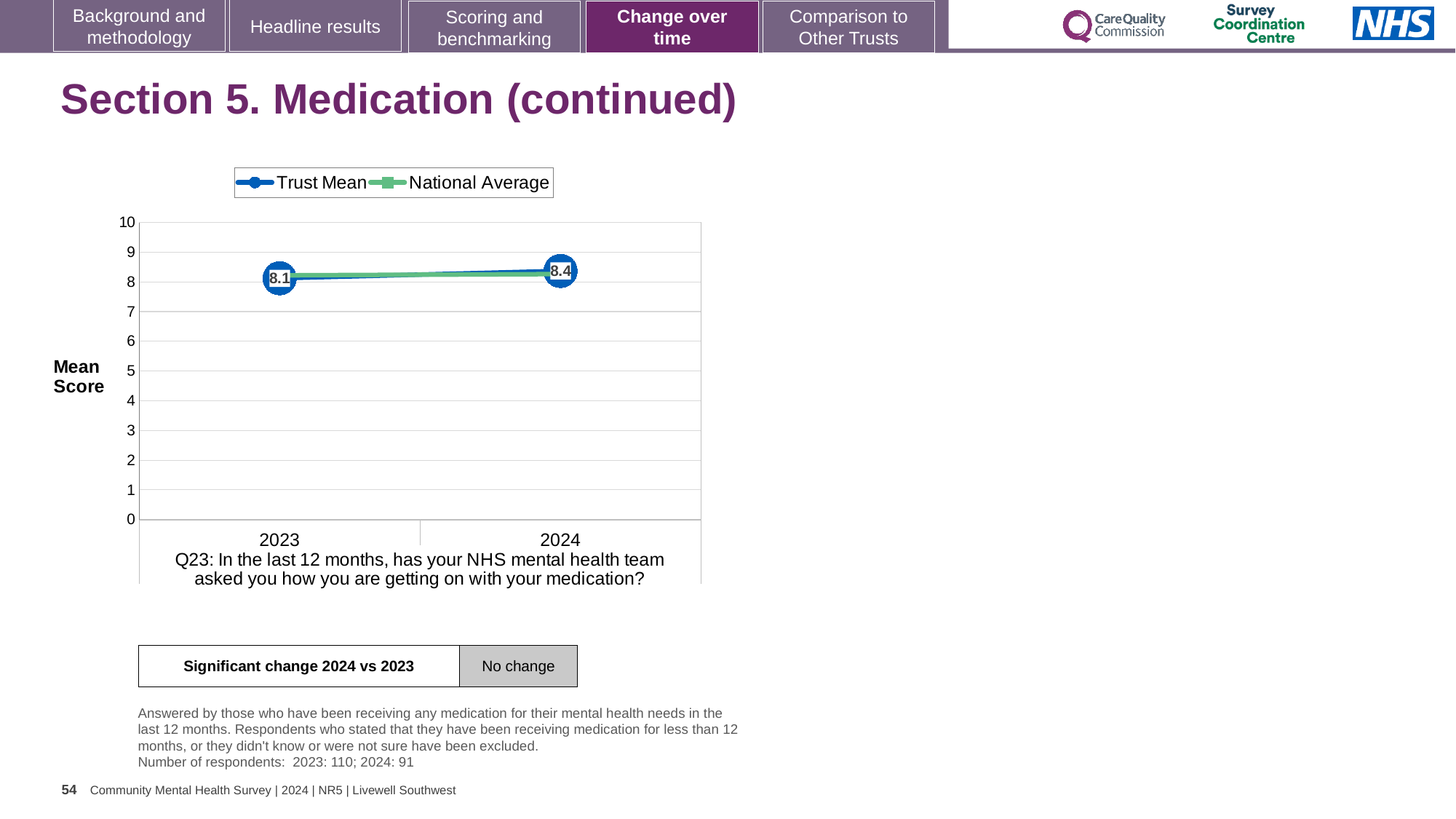
Which year has the higher Trust Mean, 2023 or 2024? 2024 What is the label on the y axis of the chart? Mean Score How many years are shown on the x axis of the chart? 2 What is the Trust Mean value for 2023? 8.1 What are the two series named in the chart legend? Trust Mean and National Average What kind of chart is shown on the slide? line chart Does the Trust Mean rise or fall from 2023 to 2024? rise How many series does the chart legend list? 2 In which year is the Trust Mean highest? 2024 Is the National Average value for 2024 greater or less than 5? greater What is the Trust Mean value for 2024? 8.4 By how much did the Trust Mean change from 2023 to 2024? 0.3